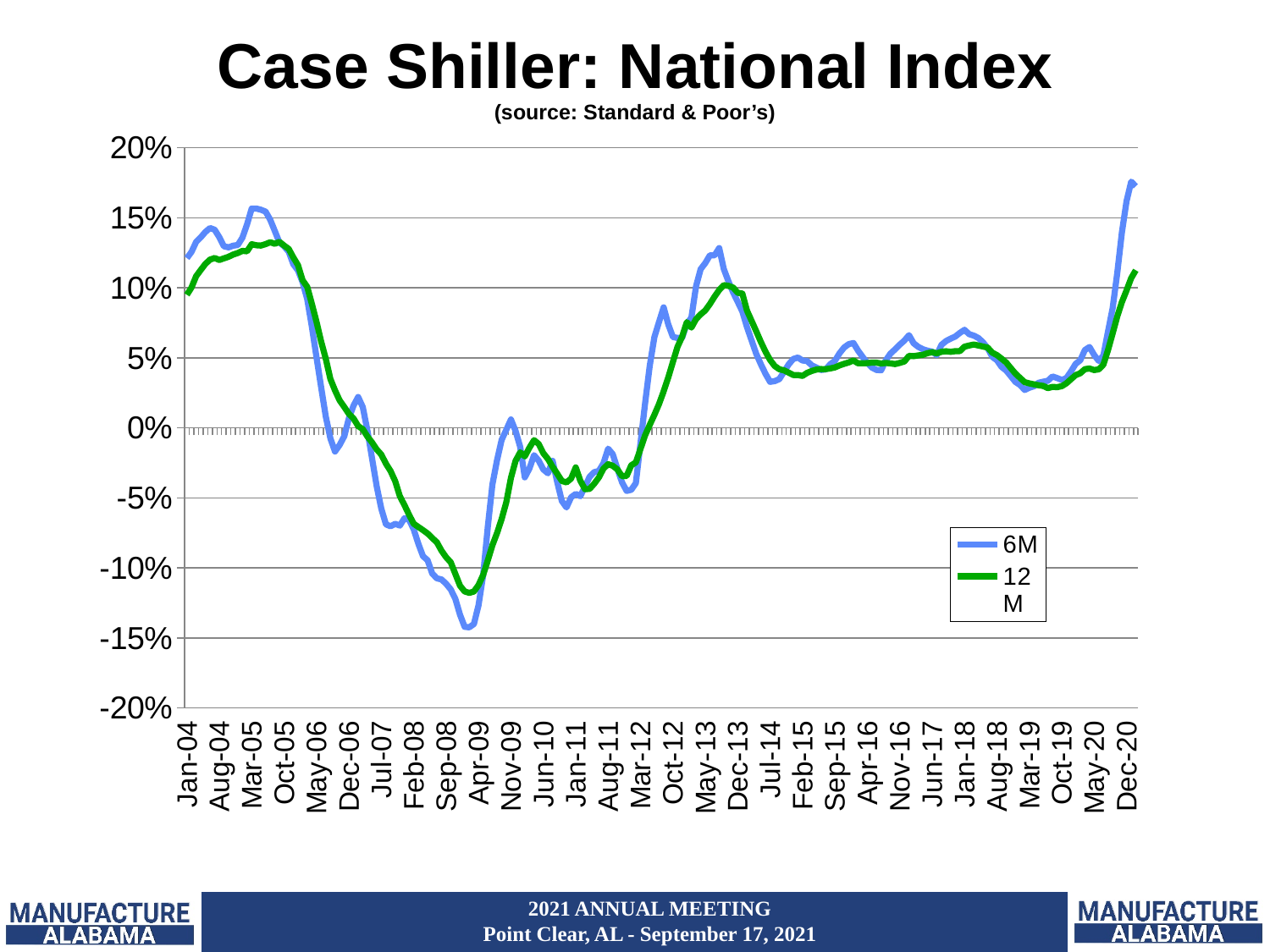
What is the title of the chart? Case Shiller: National Index Around which labelled date does the 6M series reach its lowest value? Apr-09 Is the value of the 6M series at Dec-20 greater or less than 15%? greater Does the 12M series rise or fall between Oct-05 and Apr-09? fall Which series is drawn in green according to the legend? 12M What kind of chart is shown on the slide? line chart How many series does the legend list? 2 At Apr-09, which series has the lower value, 6M or 12M? 6M Is the value of the 12M series at Oct-05 greater or less than 10%? greater Is the value of the 6M series at Apr-09 greater or less than -10%? less At Dec-20, which series has the higher value, 6M or 12M? 6M